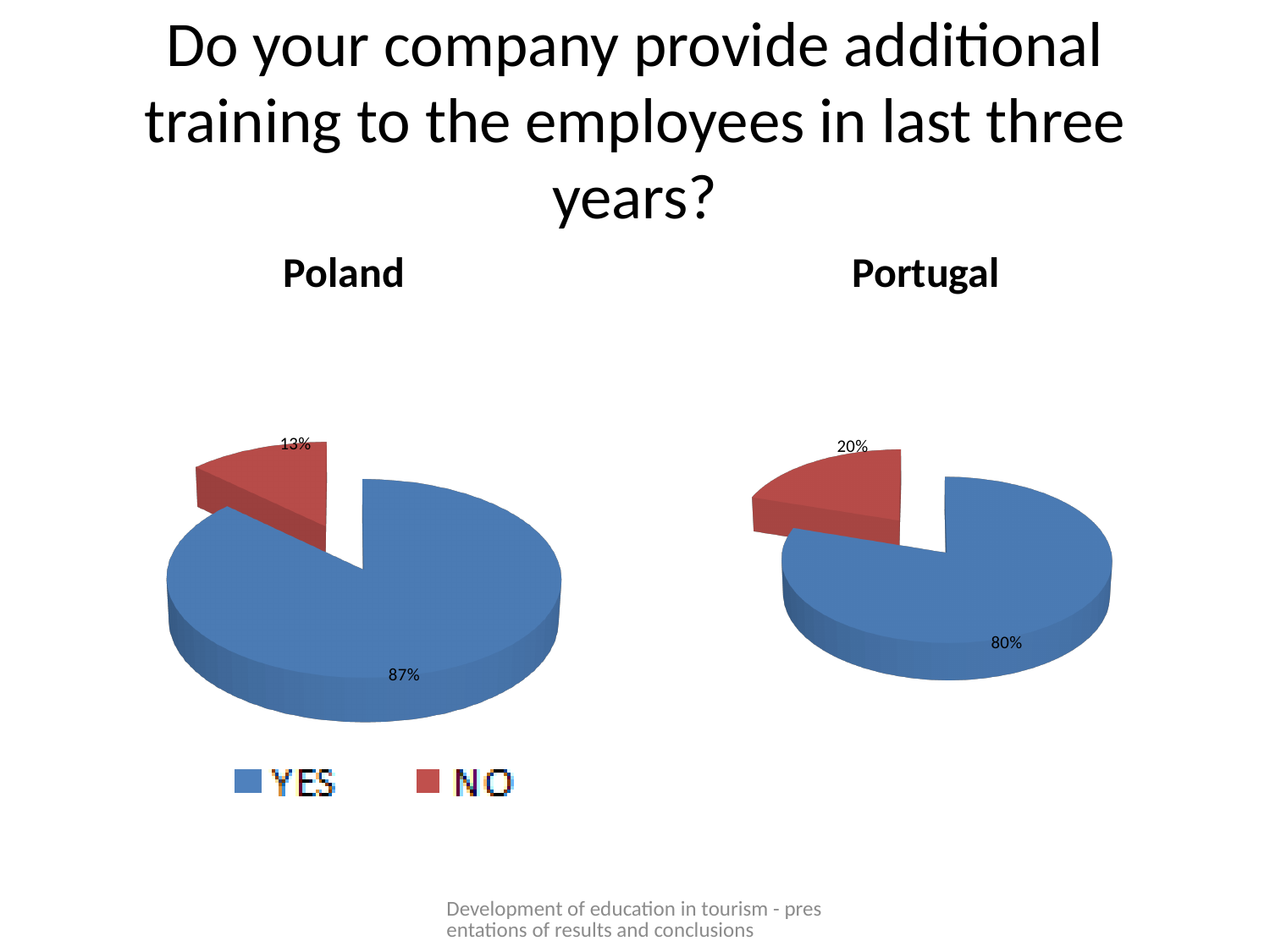
In the Poland chart, what percentage of companies answered NO? 13% How many slices does the Portugal chart have? 2 How many entries does the legend list? 2 In the Poland chart, which response has the largest slice? YES What type of chart is used for Poland and Portugal? Pie chart Which country's chart shows a larger NO share, Poland or Portugal? Portugal In the Poland chart, what percentage of companies answered YES? 87% In the Portugal chart, which response has the smallest slice? NO In the Portugal chart, what percentage of companies answered NO? 20% In the Portugal chart, what percentage of companies answered YES? 80% What colour represents the NO response in the charts? Red What is the difference between the YES and NO shares in the Poland chart? 74%